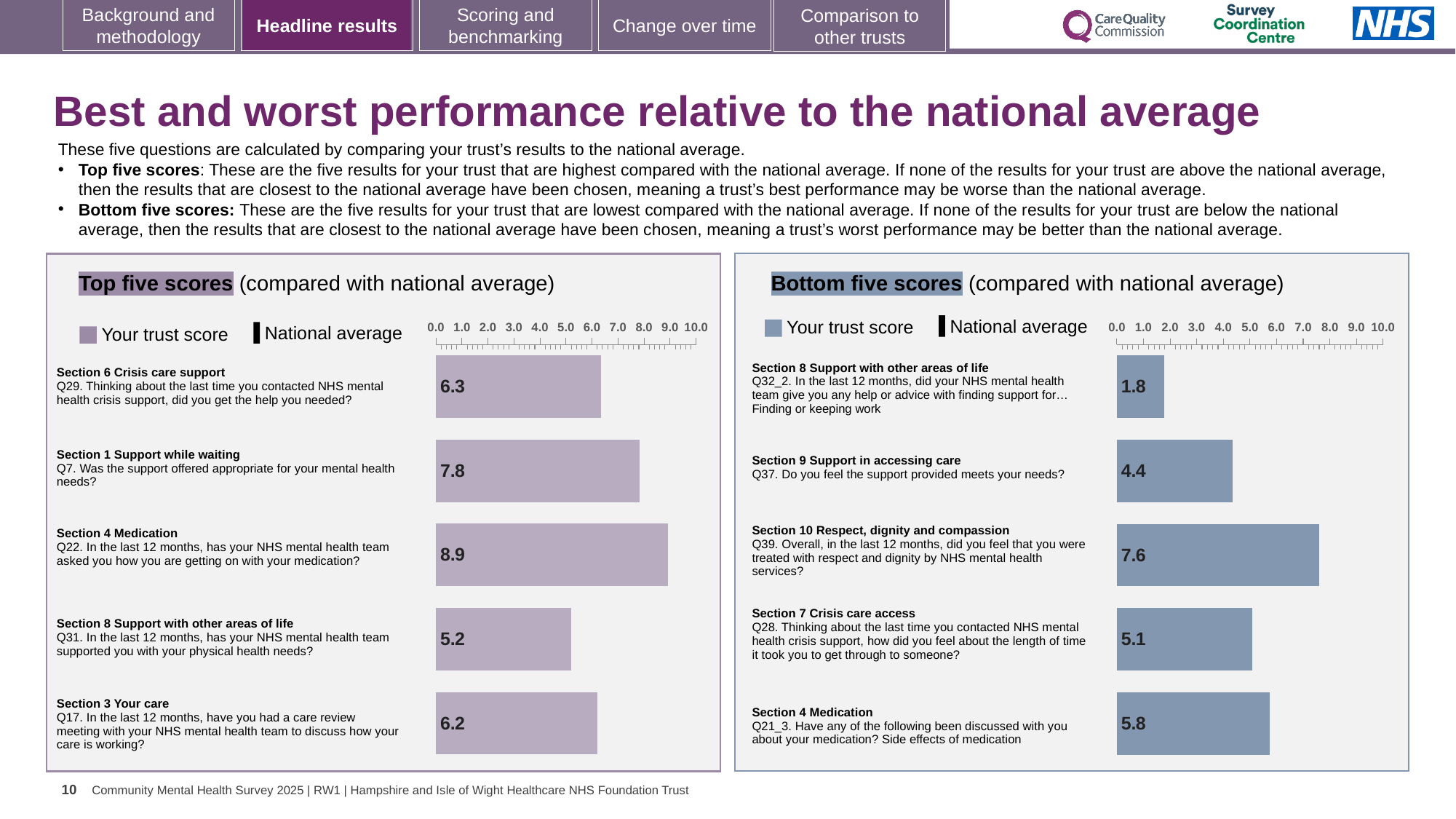
In the Top five scores chart, which question has the lowest trust score? Q31 In the Top five scores chart, what is the difference between the trust scores for Q7 and Q29? 1.5 In the Bottom five scores chart, which has the larger trust score, Q28 or Q21_3? Q21_3 In the Bottom five scores chart, what is the trust score for Q37 (Section 9 Support in accessing care)? 4.4 In the Bottom five scores chart, which question has the highest trust score? Q39 In the Top five scores chart, which question has the highest trust score? Q22 In the Bottom five scores chart, what is the trust score for Q21_3 (Section 4 Medication)? 5.8 What type of chart is the Top five scores chart? Bar chart In the Top five scores chart, what is the trust score for Q22 (Section 4 Medication)? 8.9 How many bars are plotted in the Bottom five scores chart? 5 In the Top five scores chart, what is the trust score for Q17 (Section 3 Your care)? 6.2 In the Bottom five scores chart, which question has the lowest trust score? Q32_2